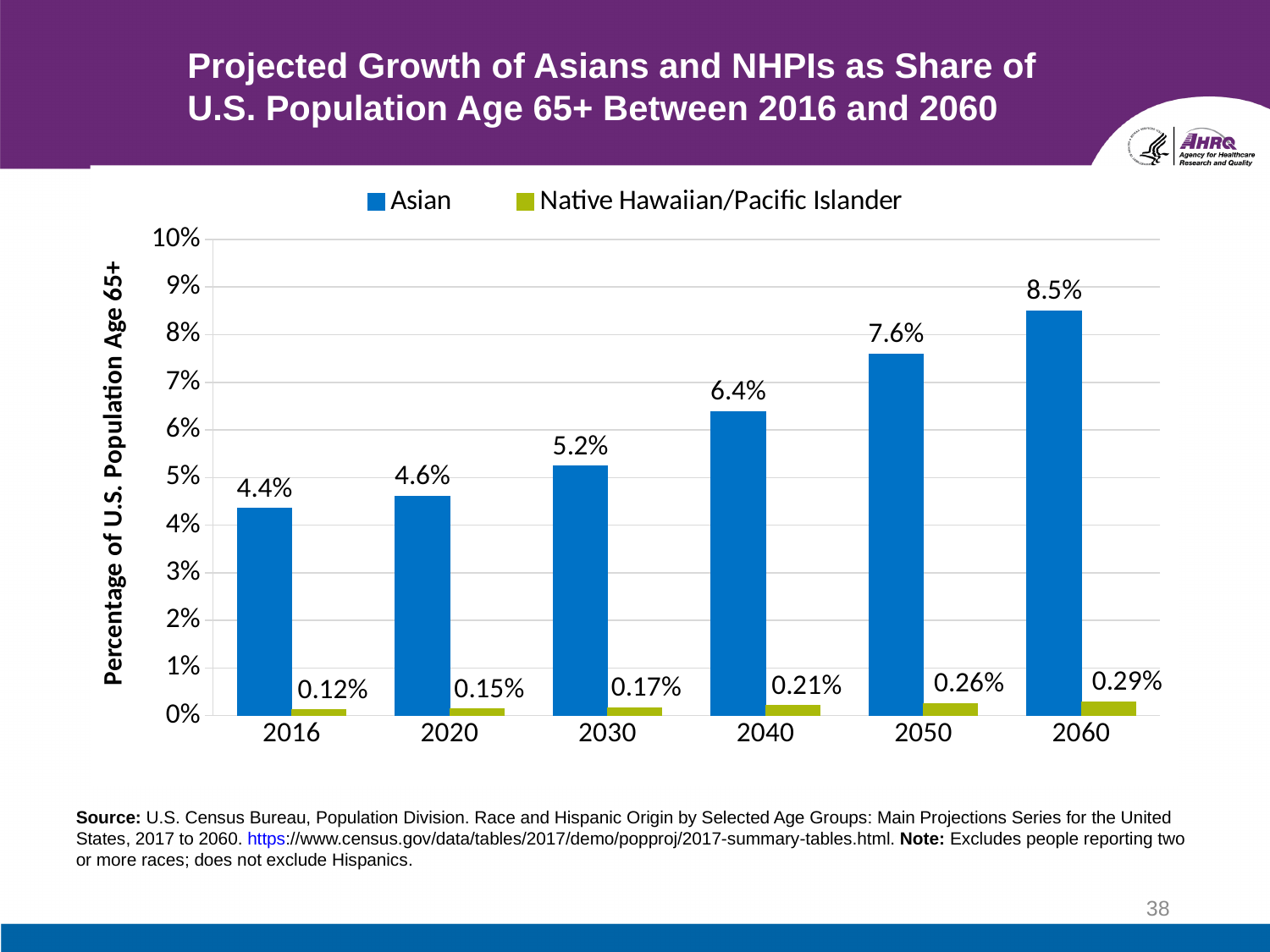
What is the projected Native Hawaiian/Pacific Islander share in 2060? 0.29% In which year is the Asian share of the population age 65+ highest? 2060 What is the difference between the Asian share in 2050 and in 2040? 1.2 percentage points Is the Asian share in 2050 greater or less than 7%? greater Which is larger, the Asian share in 2030 or the Asian share in 2020? 2030 What is the projected Native Hawaiian/Pacific Islander share of the U.S. population age 65+ in 2016? 0.12% By how many percentage points does the Asian share increase from 2016 to 2060? 4.1 percentage points What kind of chart is shown on the slide? Bar chart How many years are shown on the x axis? 6 How many series does the legend list? 2 What is the projected Asian share of the U.S. population age 65+ in 2040? 6.4% In which year is the Native Hawaiian/Pacific Islander share lowest? 2016